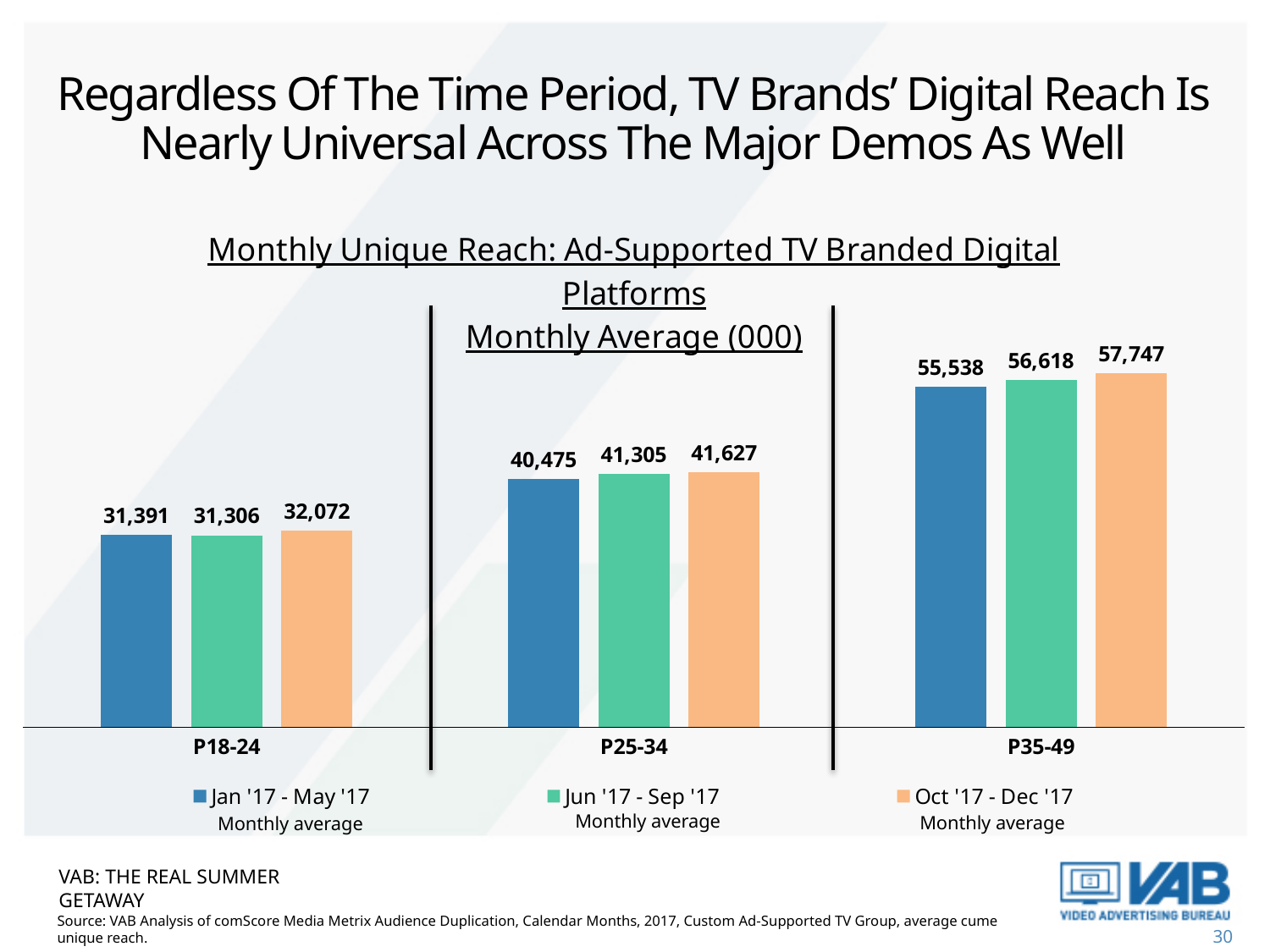
Which demo has the highest Oct '17 - Dec '17 monthly average value? P35-49 How many demo categories are shown on the x axis? 3 What is the Jan '17 - May '17 monthly average value for P18-24? 31,391 What is the Oct '17 - Dec '17 monthly average value for P35-49? 57,747 Which demo has the lowest Jan '17 - May '17 monthly average value? P18-24 Which is larger for P18-24: the Jan '17 - May '17 value or the Oct '17 - Dec '17 value? Oct '17 - Dec '17 What kind of chart is shown on the slide? Bar chart How many series does the legend list? 3 What is the difference between the Jun '17 - Sep '17 and Jan '17 - May '17 values for P25-34? 830 What is the Jun '17 - Sep '17 monthly average value for P25-34? 41,305 What is the difference between the Oct '17 - Dec '17 and Jan '17 - May '17 values for P35-49? 2,209 Do the Oct '17 - Dec '17 values rise or fall from P18-24 to P35-49? Rise